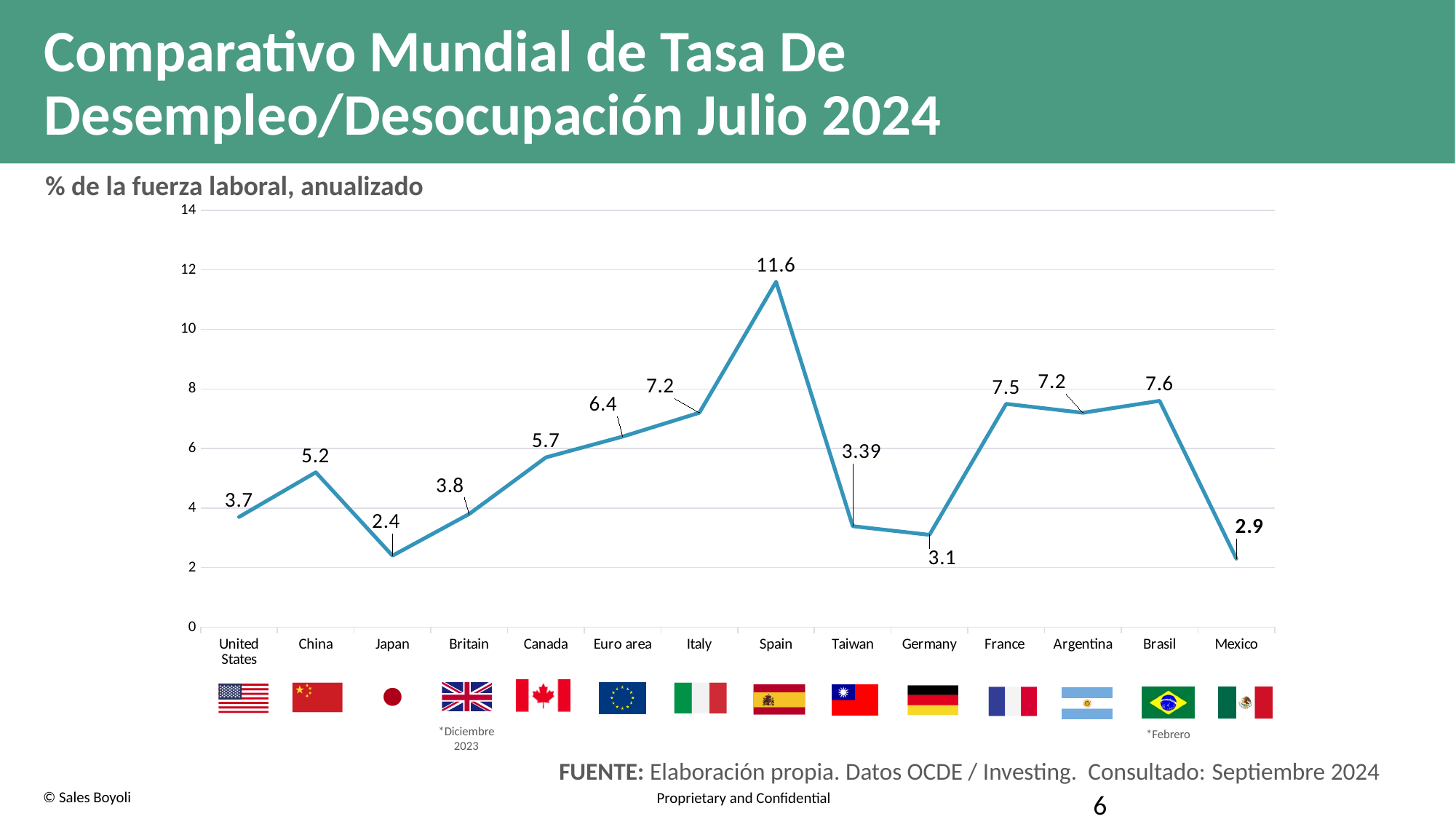
What is the unemployment rate shown for Spain? 11.6 Is the value for Euro area greater or less than 6? greater What is the value plotted for Taiwan? 3.39 What type of chart is shown on the slide? Line chart What is the subtitle describing the unit of the chart? % de la fuerza laboral, anualizado Which has a higher value, Canada or China? Canada What is the difference between the values for Brasil and France? 0.1 Which country has the highest unemployment rate on the chart? Spain What is the difference between the values for Spain and Japan? 9.2 How many countries or regions are plotted on the chart? 14 What is the value shown for Mexico? 2.9